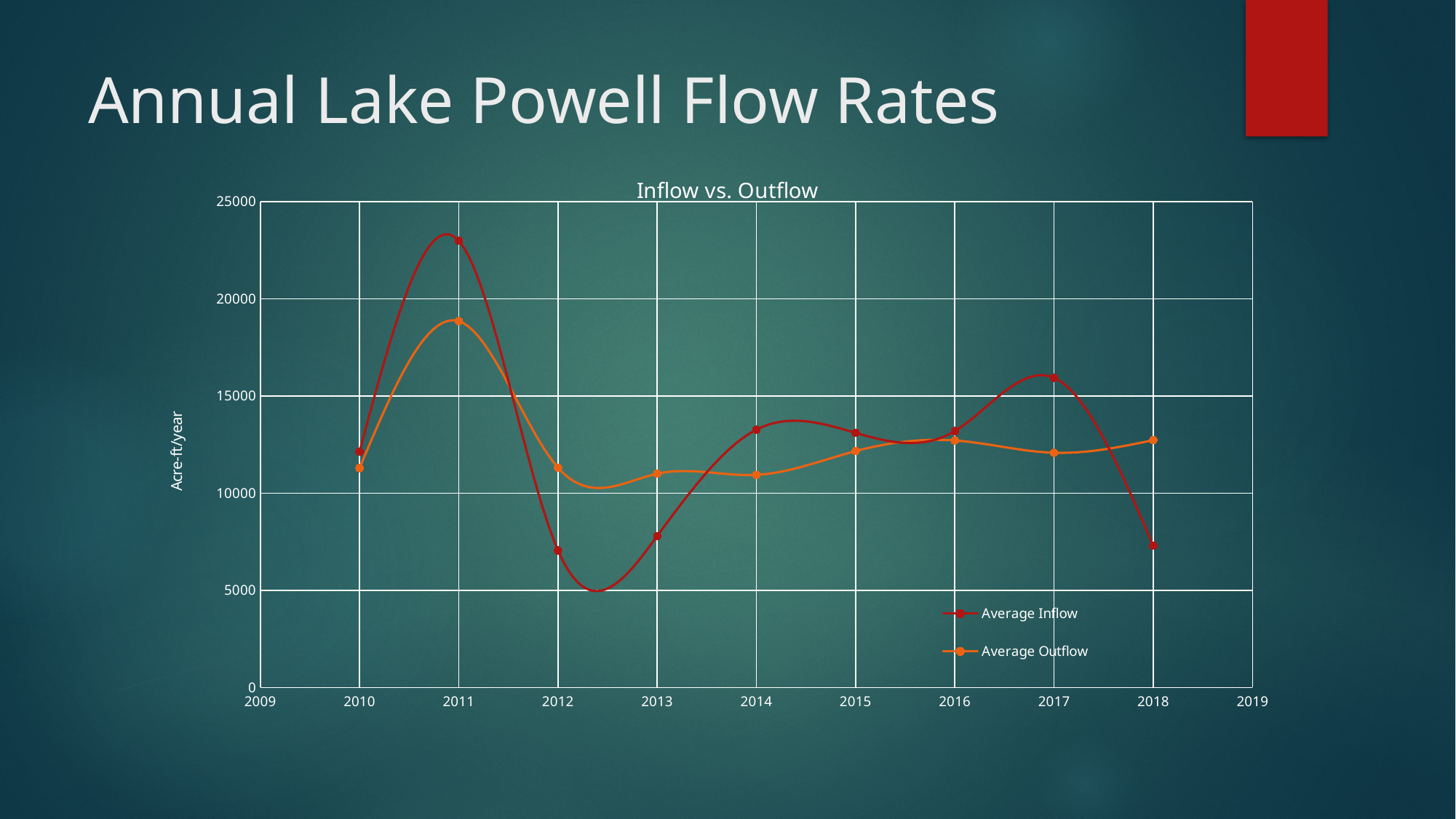
How many series does the legend list? 2 In which year is Average Outflow highest? 2011 How many years have data points plotted for Average Inflow? 9 What kind of chart is shown on the slide? line chart What is the title of the chart? Inflow vs. Outflow In 2018, which is larger: Average Inflow or Average Outflow? Average Outflow Does Average Inflow rise or fall from 2017 to 2018? fall In which year is Average Inflow lowest? 2012 In which year is Average Inflow highest? 2011 Is the Average Outflow value for 2011 greater or less than 20000? less Is the Average Inflow value for 2011 greater or less than 20000? greater Is the Average Inflow value for 2012 greater or less than 10000? less